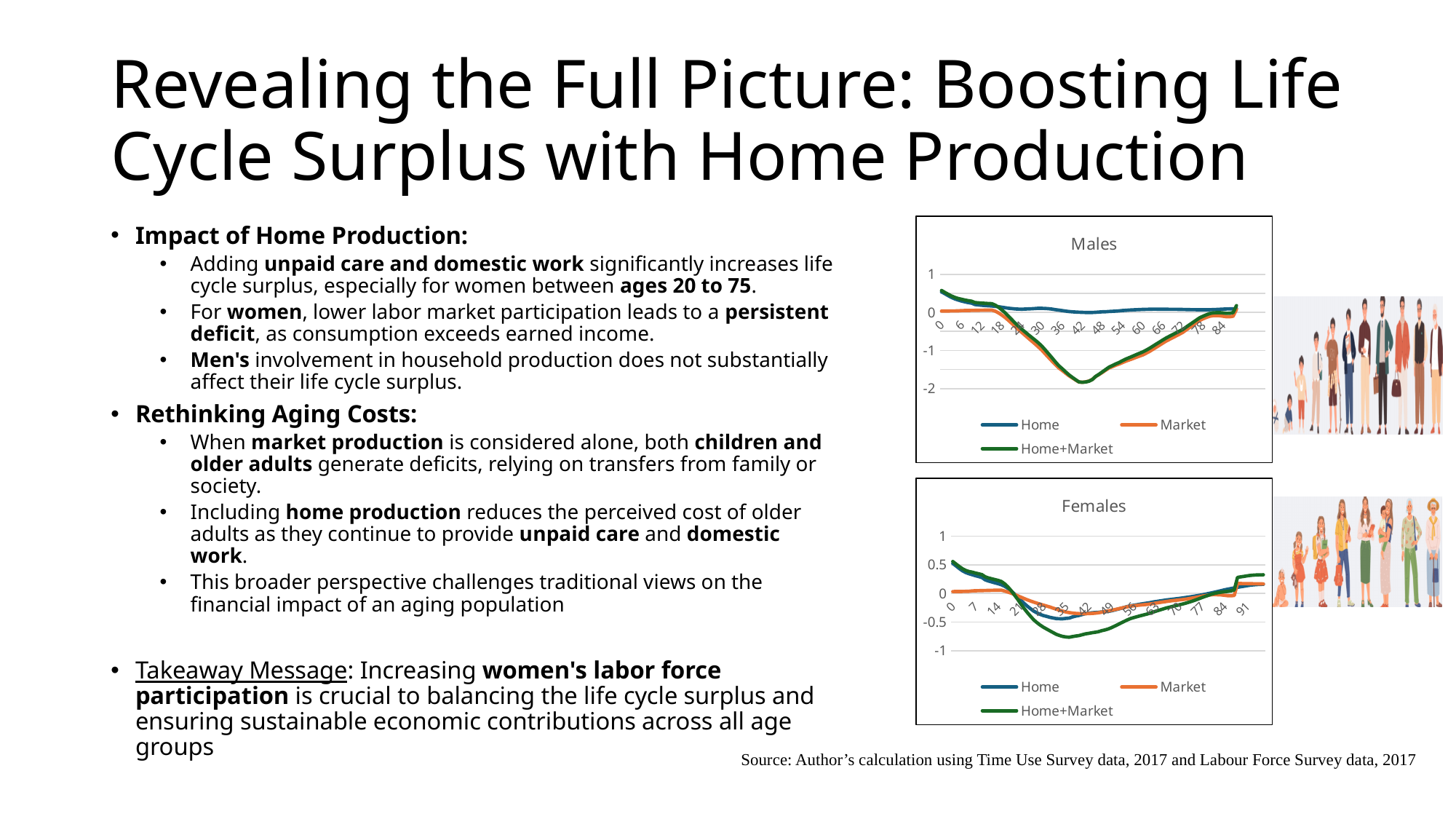
In the Females chart, is the lowest value of the Home+Market series greater or less than -0.5? less How many series does the legend of the Females chart list? 3 In the Females chart, which series reaches the lowest value? Home+Market What is the title of the lower chart on the slide? Females In the Males chart, which is larger at age 42: the Home series or the Market series? Home What kind of chart is the Males chart? line chart In the Males chart, is the value of the Home+Market series at age 42 greater or less than -1? less In the Males chart, is the value of the Home series at age 42 greater or less than -1? greater What are the names of the series in the Males chart legend? Home, Market, Home+Market In the Females chart, does the Home+Market series rise or fall between age 0 and age 35? fall